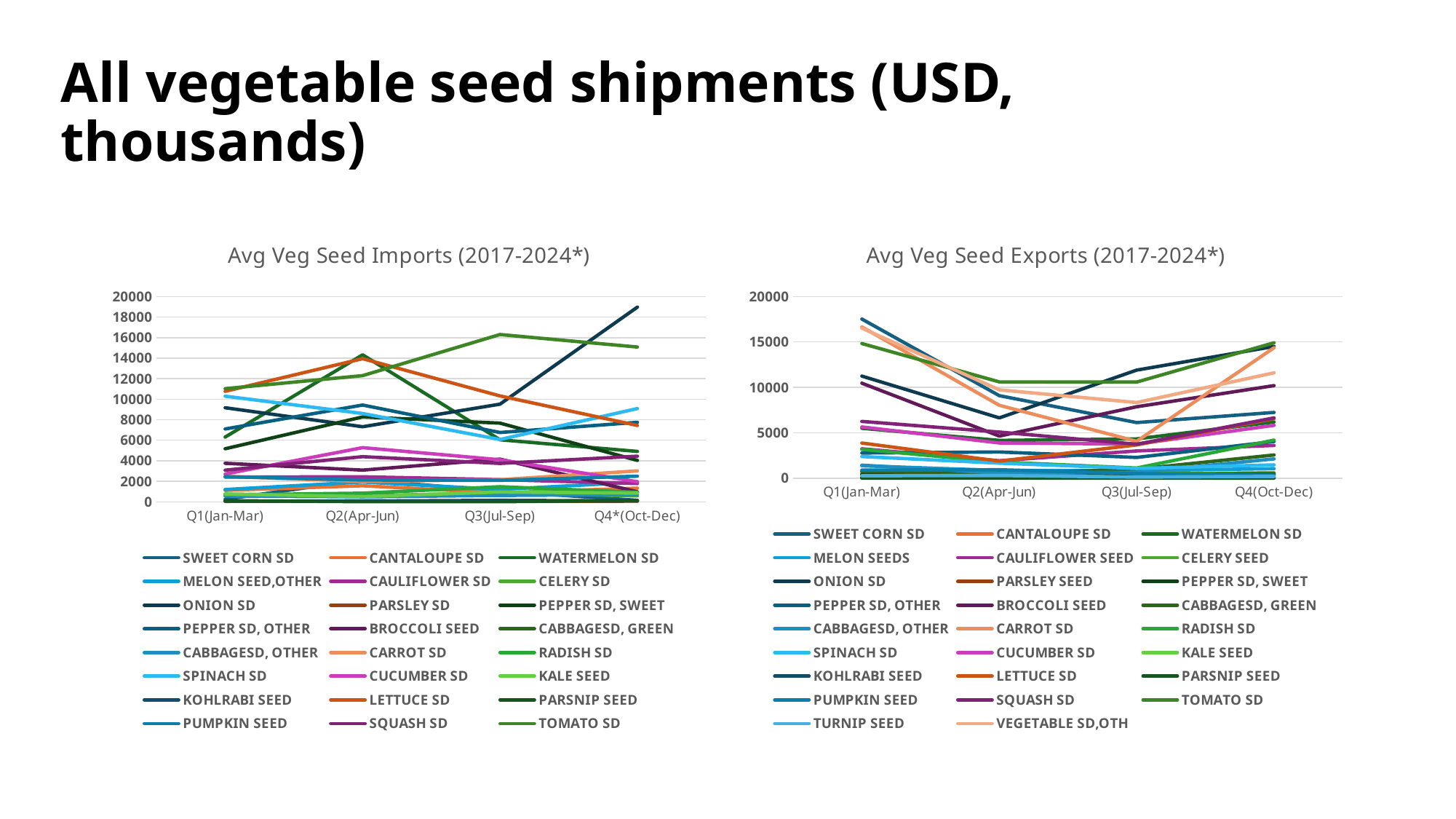
What type of chart is the Avg Veg Seed Imports (2017-2024*) chart? line chart What is the title of the chart on the left side of the slide? Avg Veg Seed Imports (2017-2024*) In the Avg Veg Seed Exports (2017-2024*) chart, is the highest plotted value greater or less than 15000? greater In the Avg Veg Seed Exports (2017-2024*) chart, is the highest plotted value greater or less than 20000? less How many categories are shown on the x axis of the Avg Veg Seed Imports (2017-2024*) chart? 4 What is the last category label on the x axis of the Avg Veg Seed Imports (2017-2024*) chart? Q4*(Oct-Dec) How many series does the legend of the Avg Veg Seed Exports (2017-2024*) chart list? 26 What type of chart is the Avg Veg Seed Exports (2017-2024*) chart? line chart How many categories are shown on the x axis of the Avg Veg Seed Exports (2017-2024*) chart? 4 How many series does the legend of the Avg Veg Seed Imports (2017-2024*) chart list? 24 In the Avg Veg Seed Imports (2017-2024*) chart, is the highest plotted value greater or less than 18000? greater